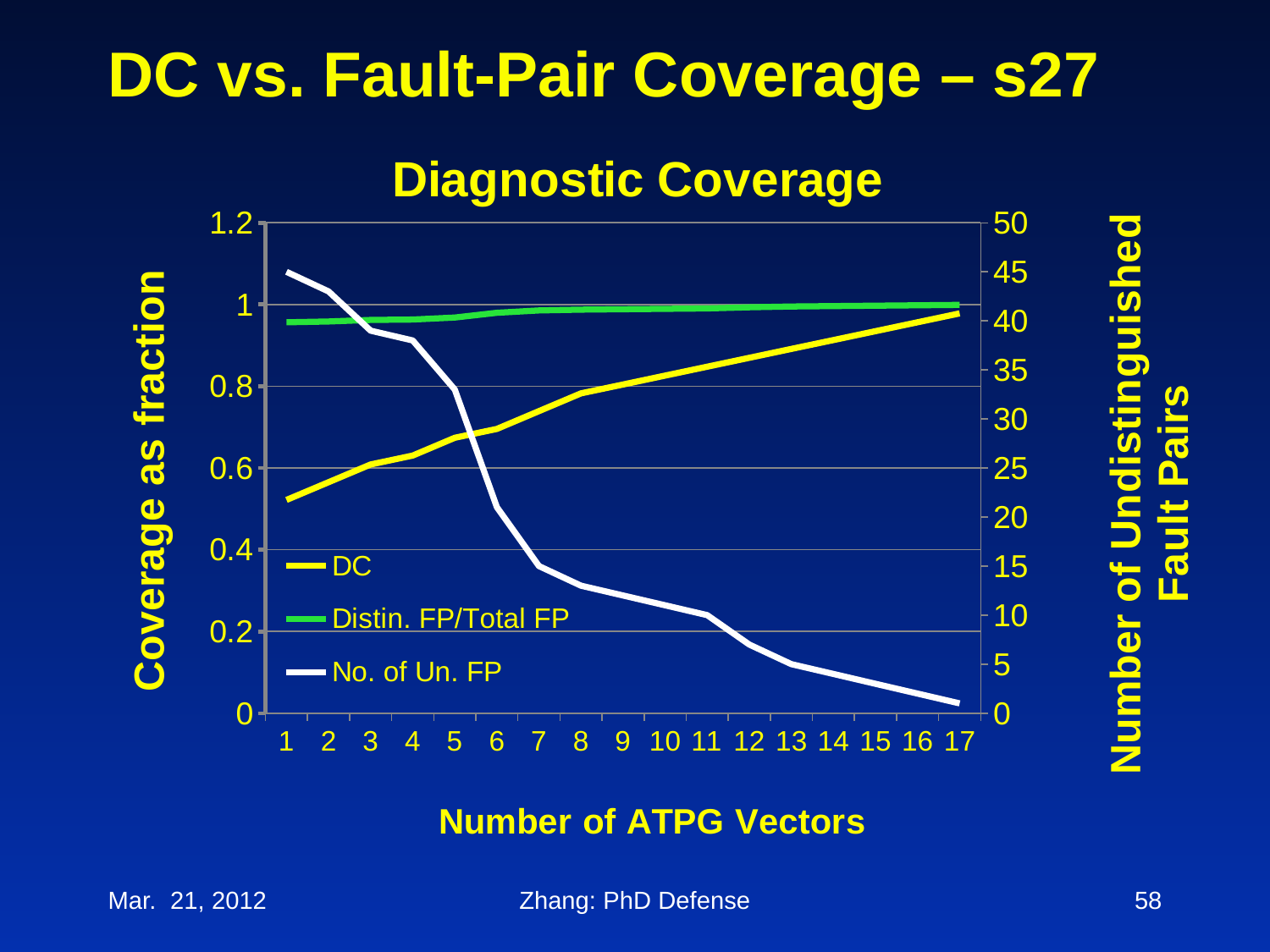
At 1 ATPG vector, which is larger: DC or Distin. FP/Total FP? Distin. FP/Total FP What kind of chart is shown on the slide? line chart Does the DC series rise or fall as the number of ATPG vectors increases? rise Does the No. of Un. FP series rise or fall as the number of ATPG vectors increases? fall How many series does the chart legend list? 3 What is the title of the chart? Diagnostic Coverage Is the DC value at 1 ATPG vector greater or less than 0.4? greater How many points are on the x axis (Number of ATPG Vectors)? 17 Is the No. of Un. FP value at 1 ATPG vector greater or less than 40? greater Is the DC value at 17 ATPG vectors greater or less than 0.8? greater